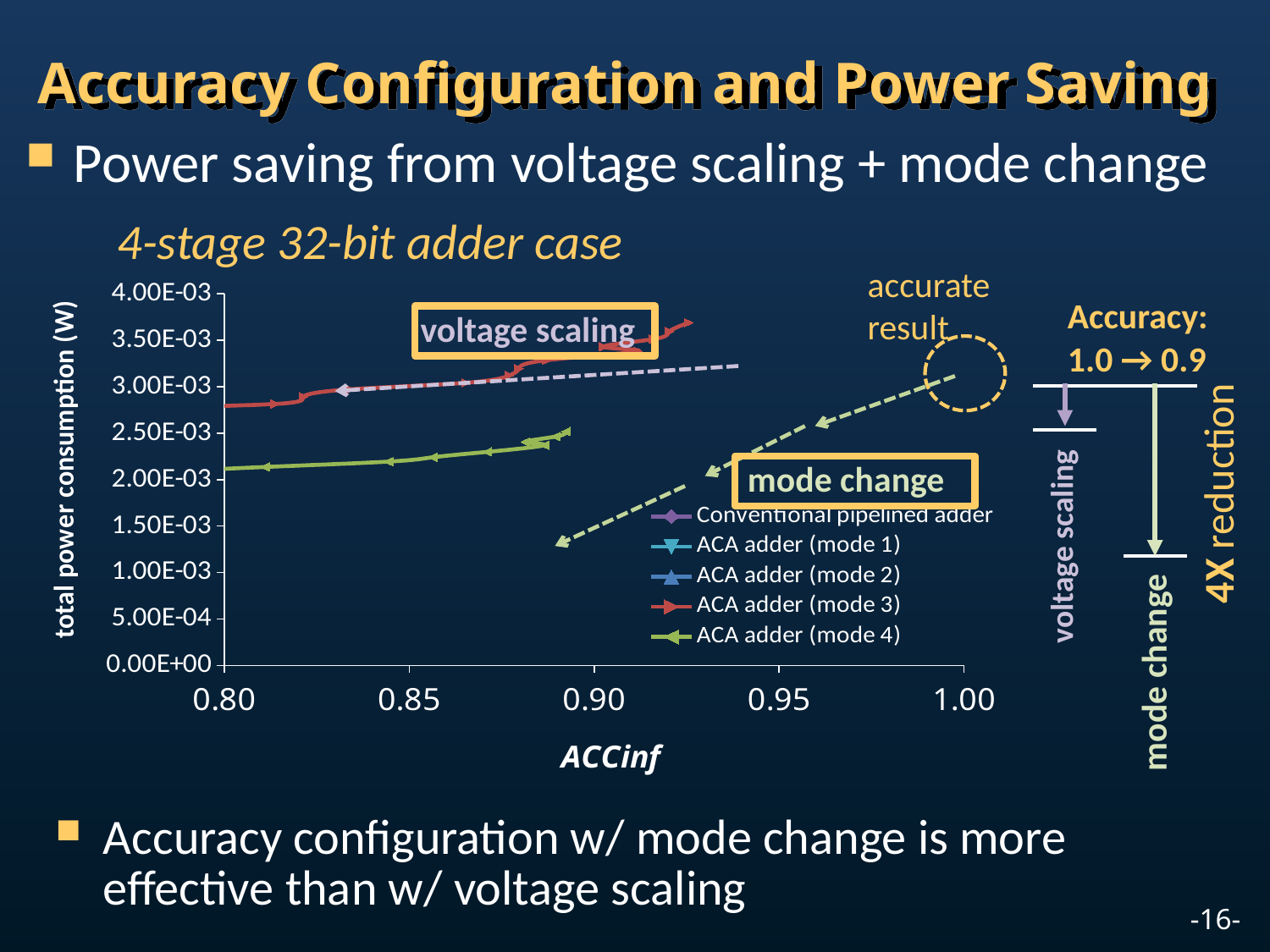
Is the value for ACA adder (mode 3) at ACCinf 0.85 greater or less than 2.50E-03? greater Does the ACA adder (mode 4) series rise or fall as ACCinf increases from 0.80 to 0.90? rise What kind of chart is shown on the slide? line chart What is the label of the y axis of the chart? total power consumption (W) Does the ACA adder (mode 3) series rise or fall as ACCinf increases from 0.80 to 0.92? rise Which series in the chart has the lowest power consumption values? ACA adder (mode 4) At ACCinf 0.85, which series has the larger value: ACA adder (mode 3) or ACA adder (mode 4)? ACA adder (mode 3) Is the value for ACA adder (mode 4) at ACCinf 0.80 greater or less than 2.50E-03? less What is the label of the x axis of the chart? ACCinf How many series does the chart legend list? 5 Is the value for ACA adder (mode 4) at ACCinf 0.85 greater or less than 3.00E-03? less